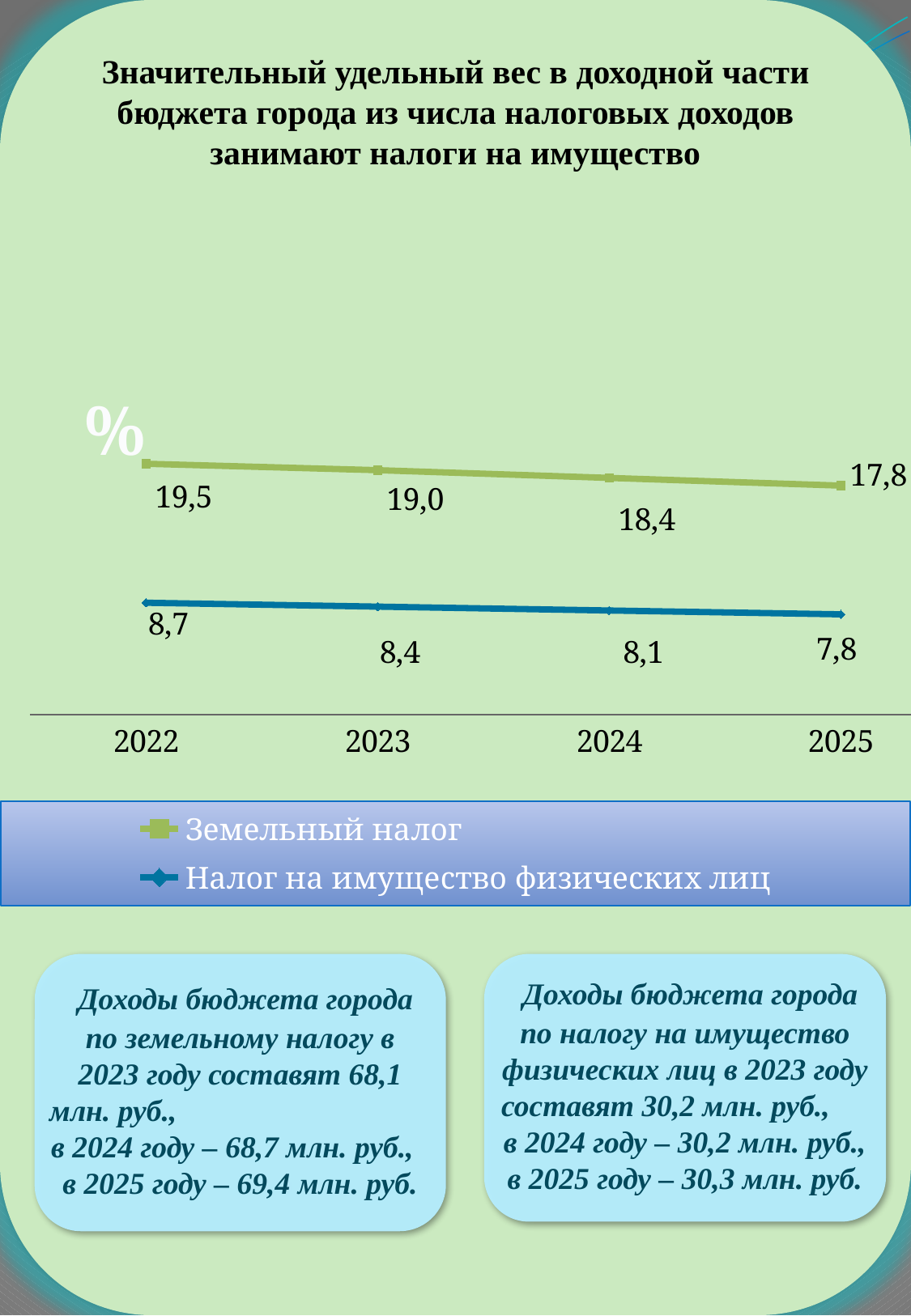
How many series does the legend list? 2 Which series has the larger value in 2024, Земельный налог or Налог на имущество физических лиц? Земельный налог In which year is the value for Налог на имущество физических лиц the highest? 2022 What is the value for Налог на имущество физических лиц in 2023? 8,4 What is the value for Налог на имущество физических лиц in 2024? 8,1 What is the difference between Земельный налог and Налог на имущество физических лиц in 2022? 10,8 What type of chart is shown on the slide? line chart Does the value for Налог на имущество физических лиц rise or fall from 2022 to 2025? fall By how much does the value for Земельный налог change from 2022 to 2025? 1,7 What is the value for Земельный налог in 2022? 19,5 In which year is the value for Земельный налог the lowest? 2025 What is the value for Земельный налог in 2025? 17,8